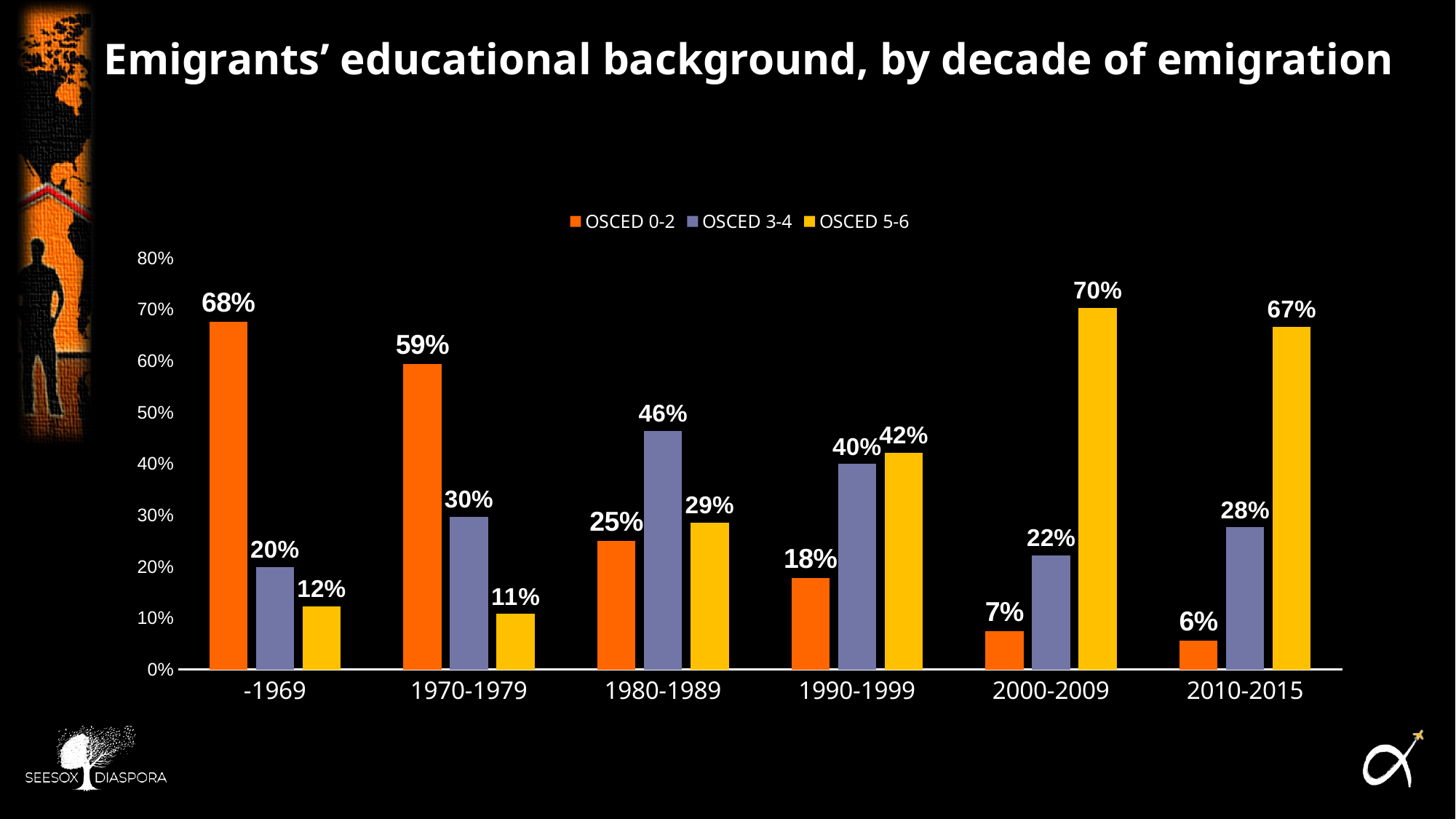
What kind of chart is shown on the slide? Bar chart In 1990-1999, which is larger: OSCED 3-4 or OSCED 5-6? OSCED 5-6 How many series does the legend list? 3 What is the value for OSCED 5-6 in 2000-2009? 70% Does the OSCED 0-2 series rise or fall across the decades from -1969 to 2010-2015? Fall What is the difference between the OSCED 5-6 value in 2000-2009 and in 2010-2015? 3% How many decade categories are shown on the x axis? 6 What is the value for OSCED 0-2 in the -1969 decade? 68% Which decade has the lowest value for OSCED 5-6? 1970-1979 Which decade has the highest value for OSCED 0-2? -1969 What colour represents OSCED 5-6 in the chart? Yellow What is the value for OSCED 3-4 in 1980-1989? 46%